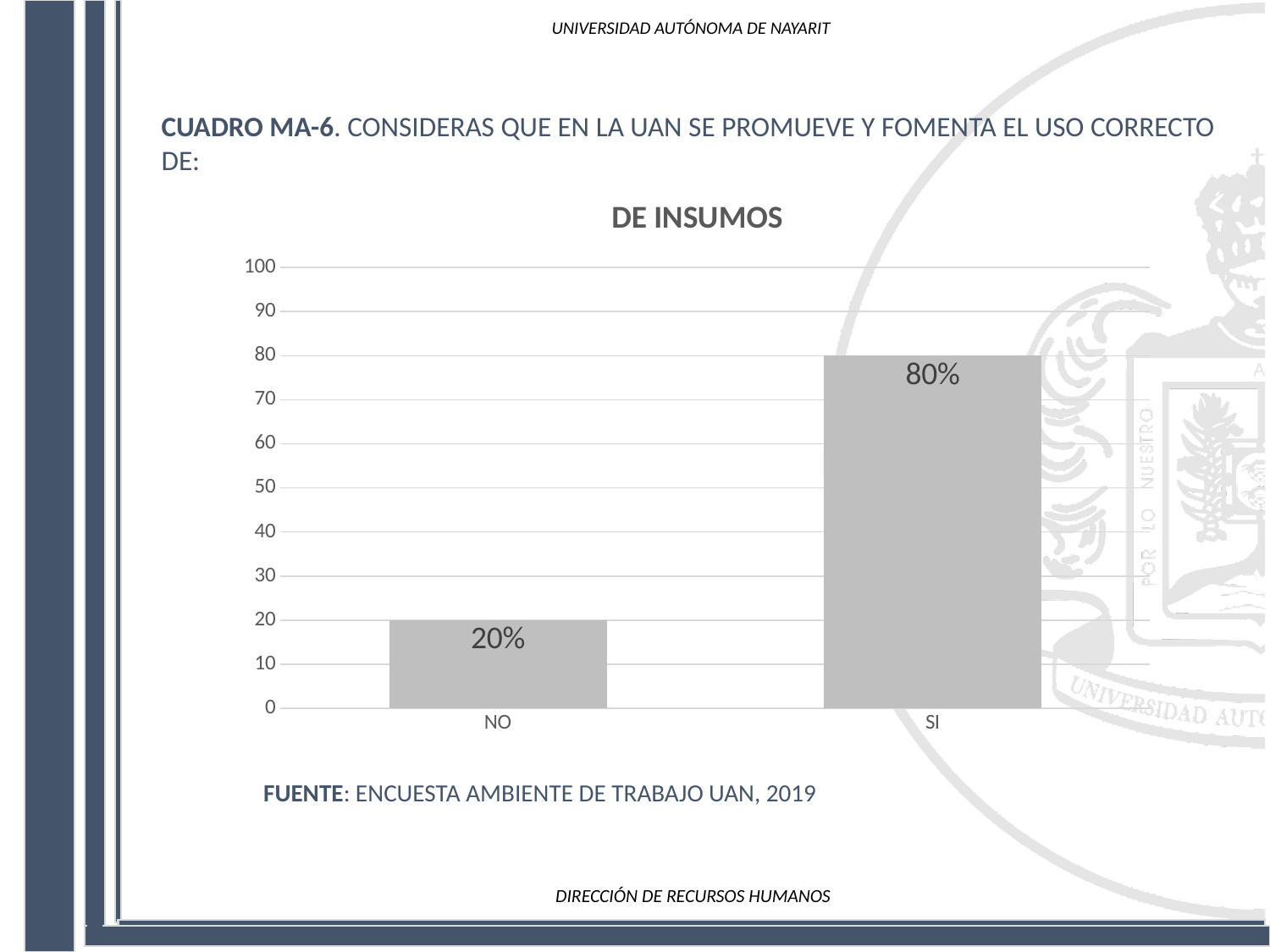
Is the value for SI greater or less than 50? greater What is the value for SI? 80% Which category has the highest value? SI Which is larger, the value for NO or the value for SI? SI Is the value for NO greater or less than 30? less What is the difference between the values for SI and NO? 60% What kind of chart is shown? bar chart How many categories are shown on the x axis? 2 Which category has the lowest value? NO What is the title of the chart? DE INSUMOS What is the maximum value shown on the y axis? 100 What is the value for NO? 20%